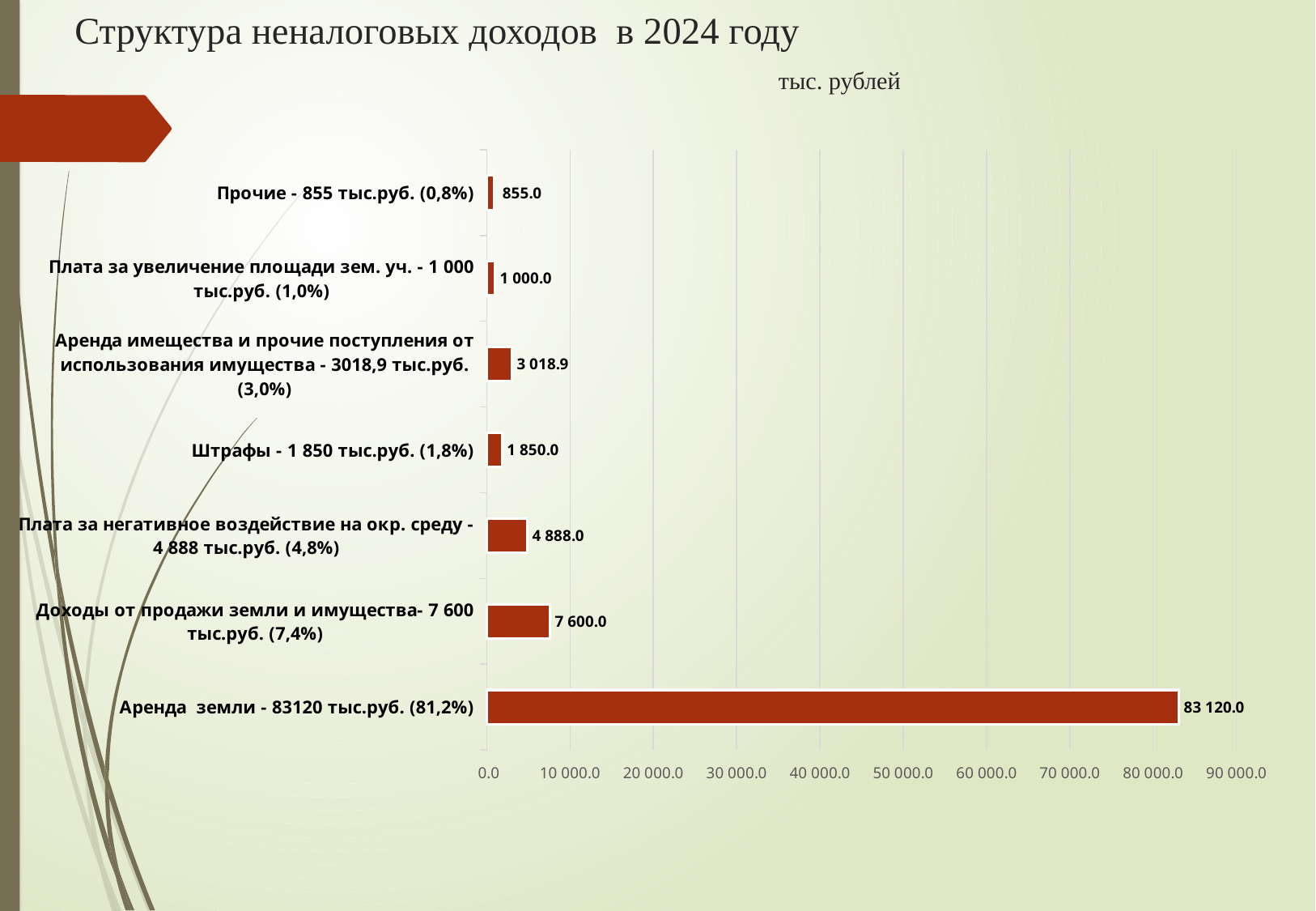
Is the value for 'Аренда земли' greater or less than 80 000.0? greater What kind of chart is shown on the slide? bar chart What is the title of the slide? Структура неналоговых доходов в 2024 году What is the value of the bar for 'Плата за негативное воздействие на окр. среду'? 4 888.0 Which category has the highest value? Аренда земли Which is larger: the value for 'Аренда имещества и прочие поступления от использования имущества' or the value for 'Штрафы'? Аренда имещества и прочие поступления от использования имущества What is the difference between the values for 'Доходы от продажи земли и имущества' and 'Плата за негативное воздействие на окр. среду'? 2 712.0 Which category has the lowest value? Прочие How many categories are shown in the chart? 7 What is the value of the bar for 'Аренда земли'? 83 120.0 What is the value of the bar for 'Штрафы'? 1 850.0 What share of non-tax revenue does 'Аренда земли' account for, according to its label? 81,2%